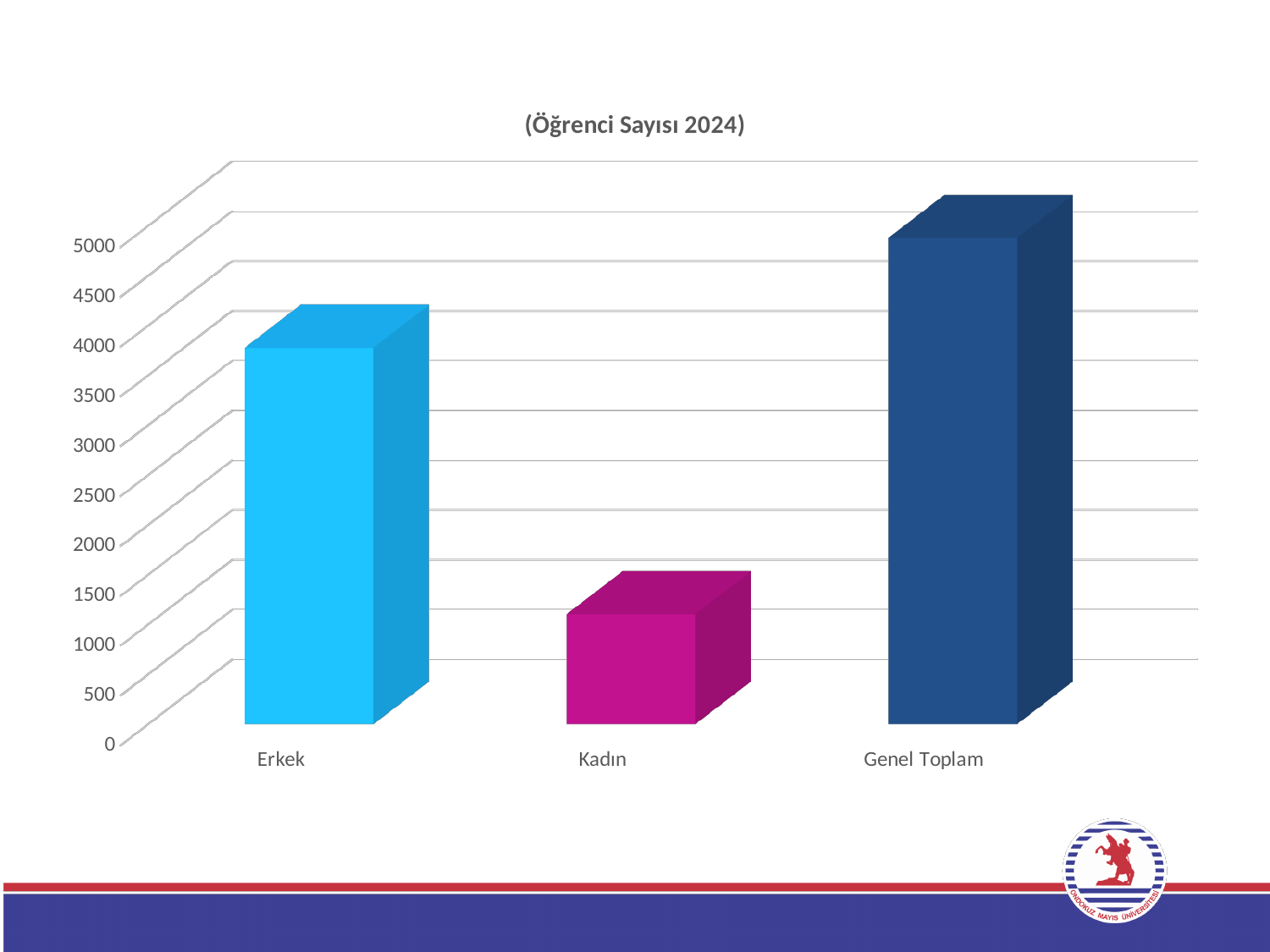
Is the value for Kadın greater or less than 2000? less Which category has the lowest value in the chart? Kadın Is the value for Erkek greater or less than 4500? less What is the highest value labelled on the vertical axis of the chart? 5000 What kind of chart is shown on the slide? bar chart Is the value for Erkek greater or less than 3000? greater What is the title of the chart? (Öğrenci Sayısı 2024) Which category has the highest value in the chart? Genel Toplam Which is larger, the value for Erkek or the value for Kadın? Erkek How many categories are shown on the x axis of the chart? 3 Which is larger, the value for Genel Toplam or the value for Erkek? Genel Toplam